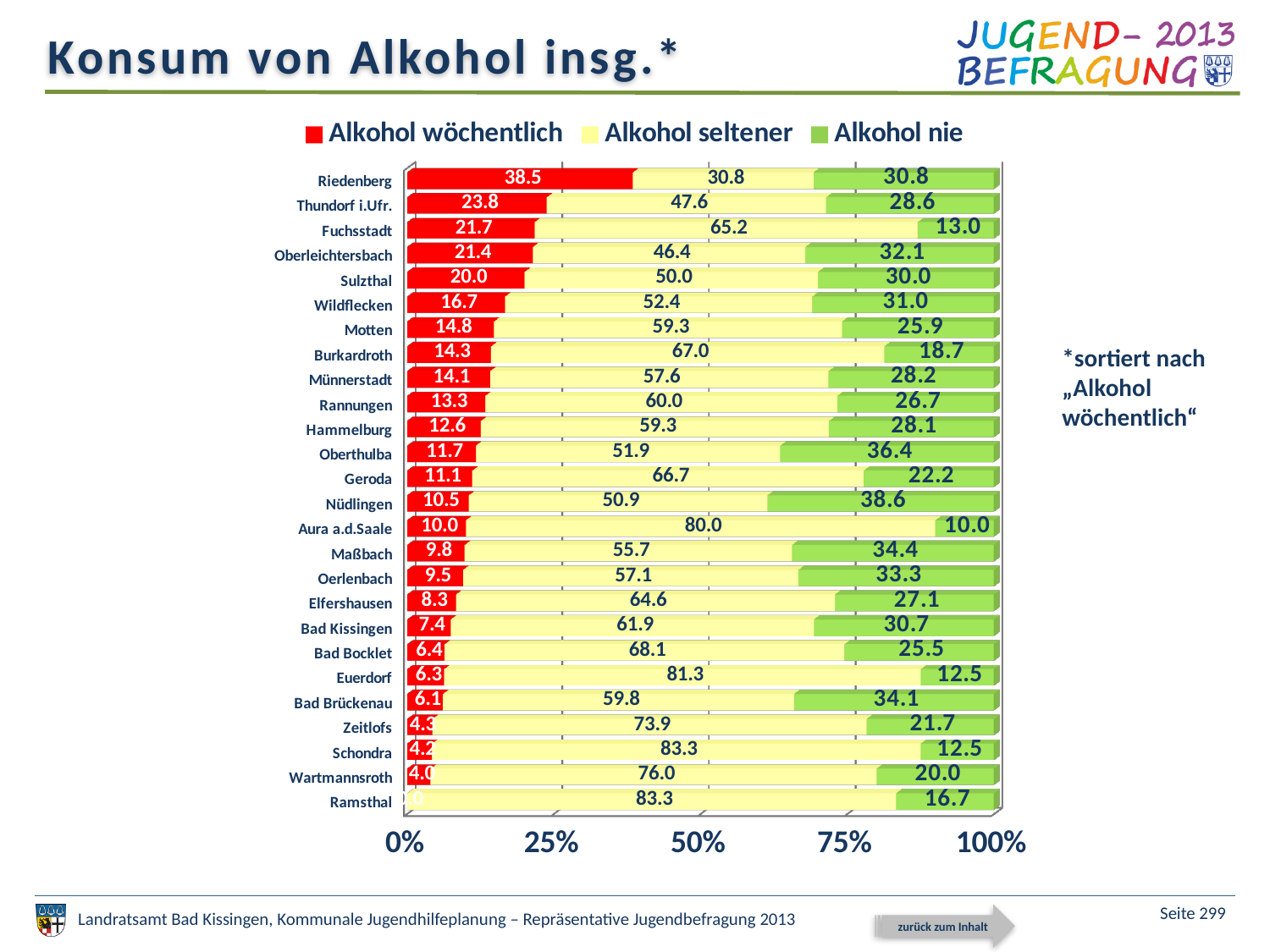
What is the value for "Alkohol wöchentlich" in Riedenberg? 38.5 What is the value for "Alkohol nie" in Fuchsstadt? 13.0 What is the value for "Alkohol seltener" in Aura a.d.Saale? 80.0 What kind of chart is shown on the slide? Stacked bar chart Which has the larger "Alkohol seltener" value, Fuchsstadt or Oberleichtersbach? Fuchsstadt Which municipality has the highest value for "Alkohol wöchentlich"? Riedenberg According to the note on the slide, by which series is the chart sorted? Alkohol wöchentlich How many municipalities are shown on the chart? 26 Which municipality has the lowest value for "Alkohol nie"? Aura a.d.Saale What is the difference between the "Alkohol wöchentlich" values for Riedenberg and Thundorf i.Ufr.? 14.7 Which municipality has the highest value for "Alkohol nie"? Nüdlingen How many series does the legend list? 3